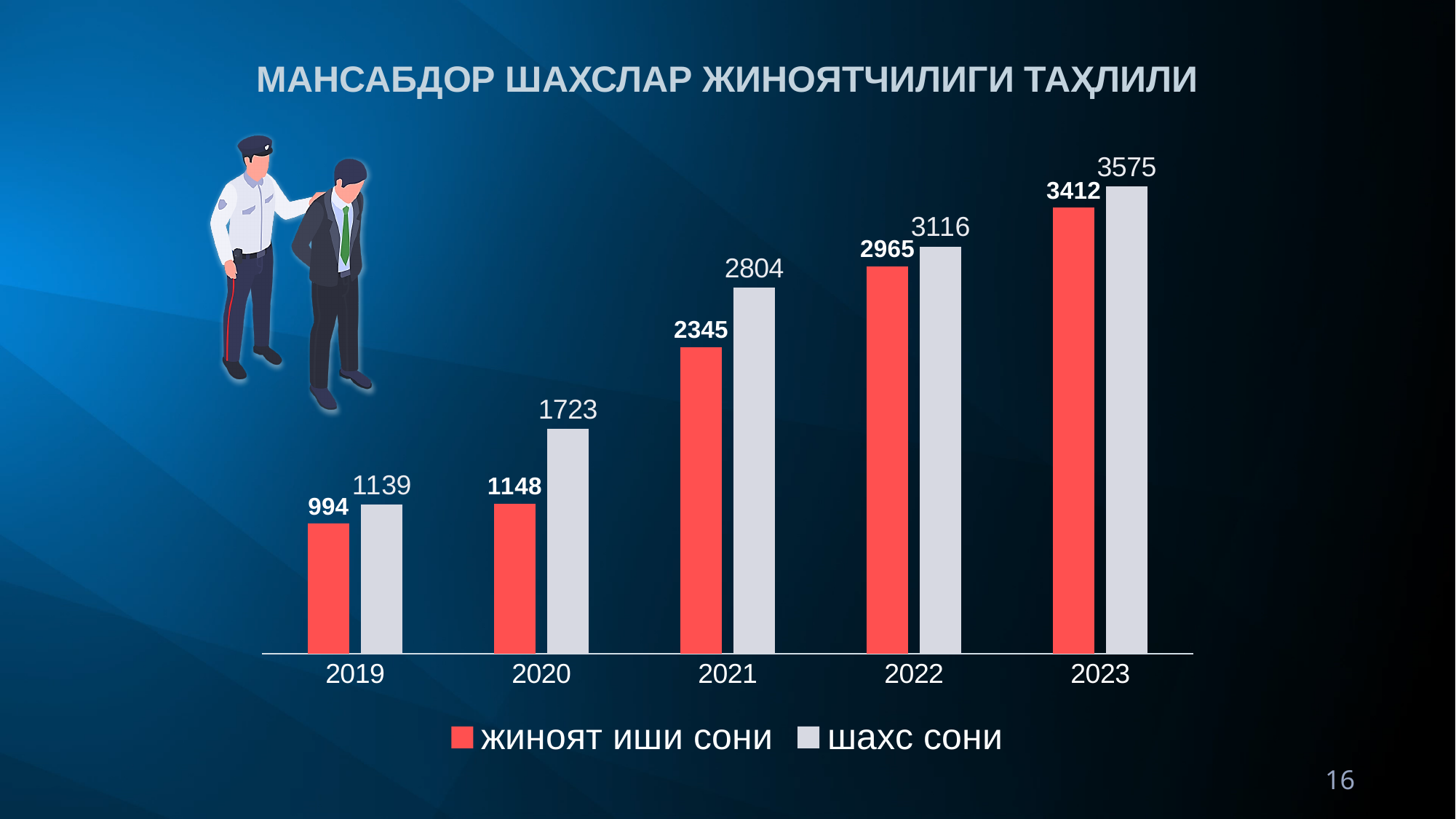
What is the difference between the "жиноят иши сони" values for 2023 and 2019? 2418 Do the "шахс сони" values rise or fall from 2019 to 2023? rise What is the value of "жиноят иши сони" for 2021? 2345 What is the difference between "шахс сони" and "жиноят иши сони" in 2022? 151 Which year has the lowest value for "шахс сони"? 2019 Which year has the highest value for "жиноят иши сони"? 2023 What kind of chart is shown on the slide? bar chart How many series does the legend list? 2 Which is larger in 2020: "жиноят иши сони" or "шахс сони"? шахс сони What is the value of "шахс сони" for 2023? 3575 What is the value of "шахс сони" for 2020? 1723 How many years are shown on the x axis? 5